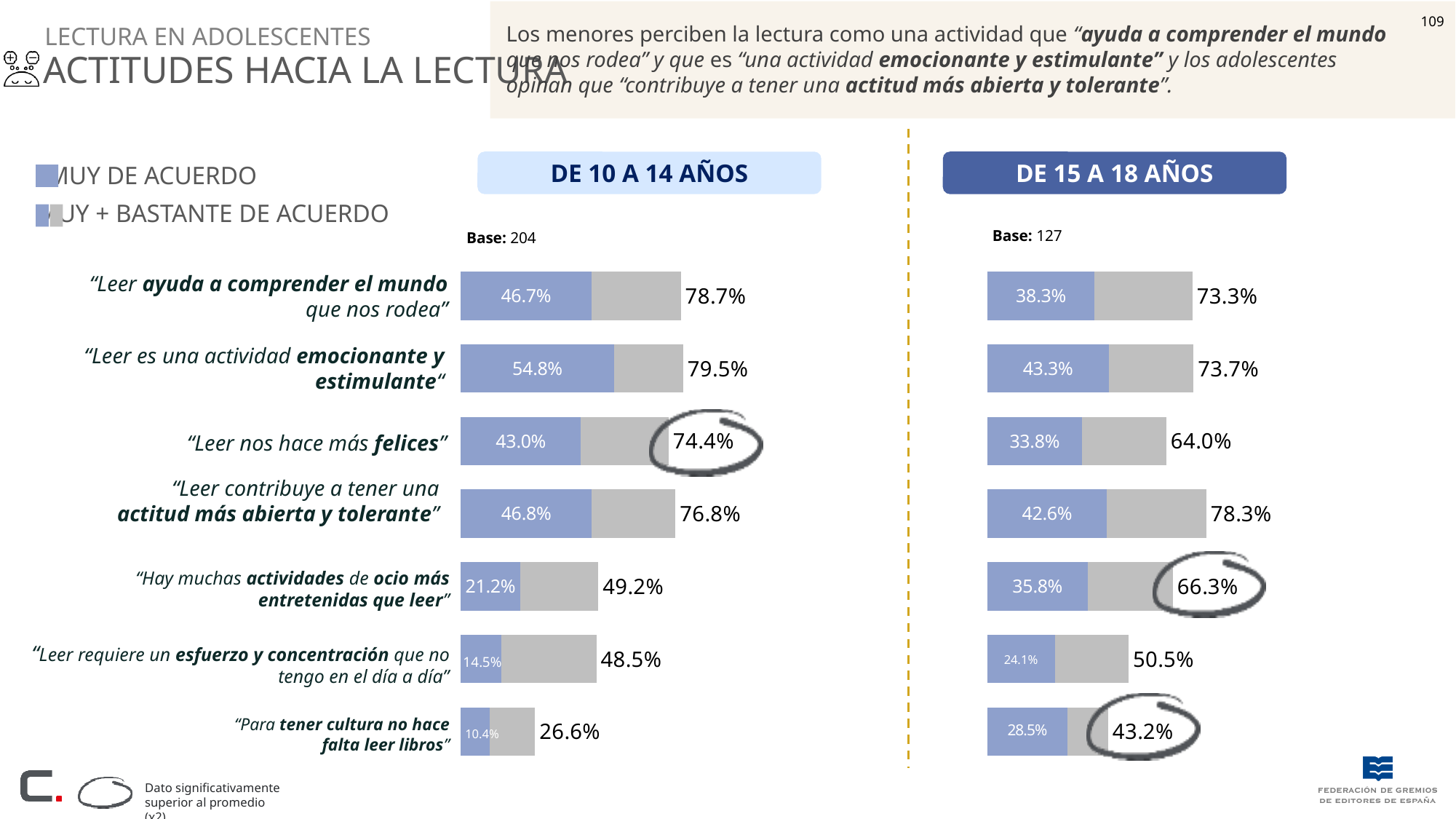
In the 'DE 15 A 18 AÑOS' chart, which statement has the lowest 'Muy + bastante de acuerdo' value? Para tener cultura no hace falta leer libros In the 'DE 10 A 14 AÑOS' chart, what is the difference between the 'Muy + bastante de acuerdo' value and the 'Muy de acuerdo' value for 'Leer nos hace más felices'? 31.4% In the 'DE 15 A 18 AÑOS' chart, what is the 'Muy de acuerdo' value for 'Leer nos hace más felices'? 33.8% What is the base (sample size) shown for the 'DE 15 A 18 AÑOS' chart? 127 Which is larger: the 'Muy + bastante de acuerdo' value for 'Leer contribuye a tener una actitud más abierta y tolerante' in the 'DE 10 A 14 AÑOS' chart or in the 'DE 15 A 18 AÑOS' chart? DE 15 A 18 AÑOS In the 'DE 10 A 14 AÑOS' chart, what is the 'Muy + bastante de acuerdo' value for 'Leer ayuda a comprender el mundo que nos rodea'? 78.7% How many series does the legend list? 2 What kind of chart is the 'DE 10 A 14 AÑOS' chart? Bar chart In the 'DE 10 A 14 AÑOS' chart, which statement has the lowest 'Muy de acuerdo' value? Para tener cultura no hace falta leer libros How many statements are plotted in the 'DE 15 A 18 AÑOS' chart? 7 In the 'DE 15 A 18 AÑOS' chart, what is the 'Muy + bastante de acuerdo' value for 'Hay muchas actividades de ocio más entretenidas que leer'? 66.3% In the 'DE 10 A 14 AÑOS' chart, which statement has the highest 'Muy + bastante de acuerdo' value? Leer es una actividad emocionante y estimulante